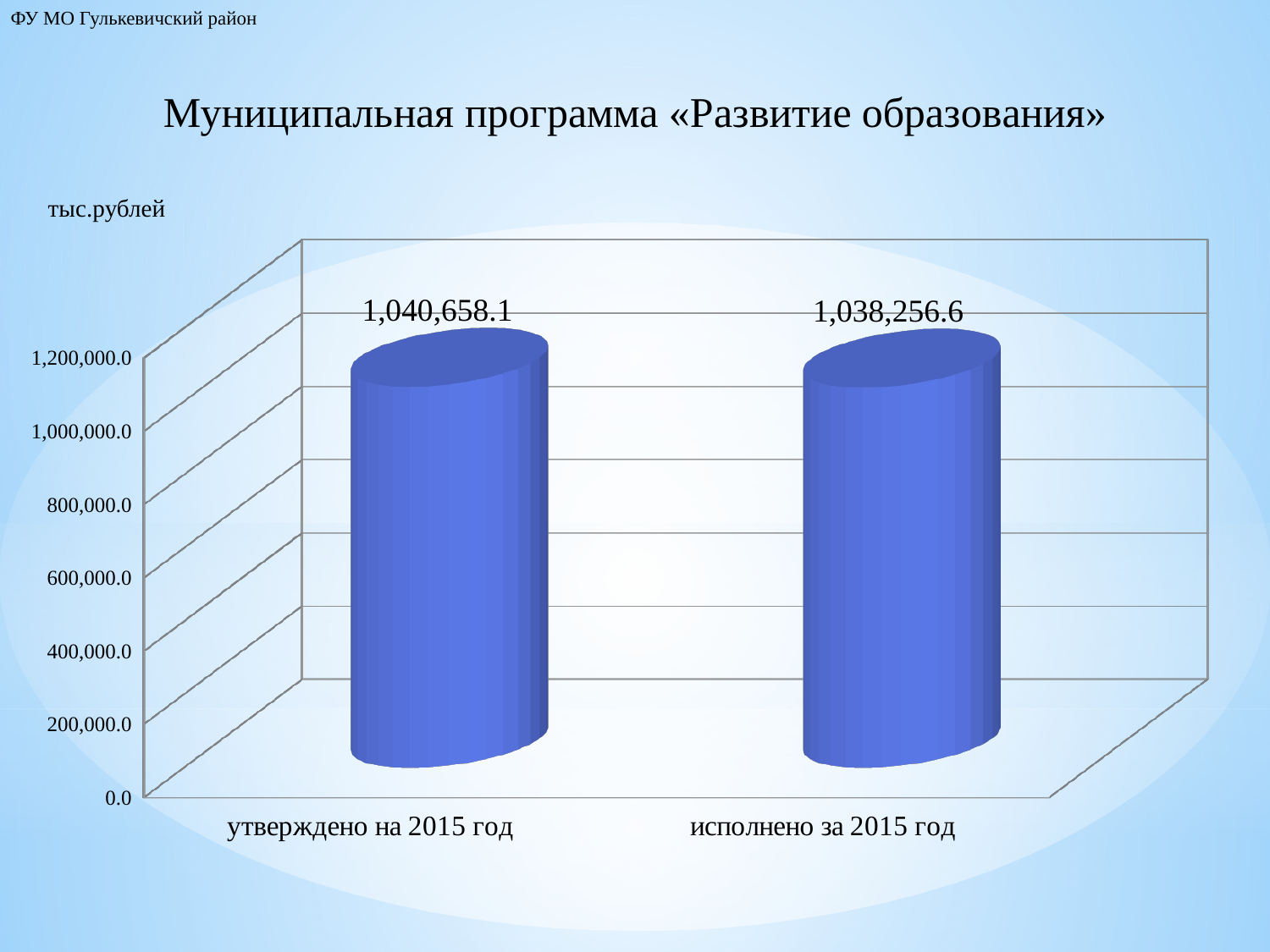
Which category has the higher value? утверждено на 2015 год Is the value for «утверждено на 2015 год» larger or smaller than the value for «исполнено за 2015 год»? larger How many categories are shown on the chart? 2 What is the difference between the value for «утверждено на 2015 год» and the value for «исполнено за 2015 год»? 2,401.5 What kind of chart is shown on the slide? bar chart What is the title of the chart? Муниципальная программа «Развитие образования» In what units are the values on the chart expressed? тыс.рублей Which category has the lower value? исполнено за 2015 год Is the value for «утверждено на 2015 год» greater or less than 1,200,000.0? less What is the value for «утверждено на 2015 год»? 1,040,658.1 What is the value for «исполнено за 2015 год»? 1,038,256.6 Is the value for «исполнено за 2015 год» greater or less than 1,000,000.0? greater